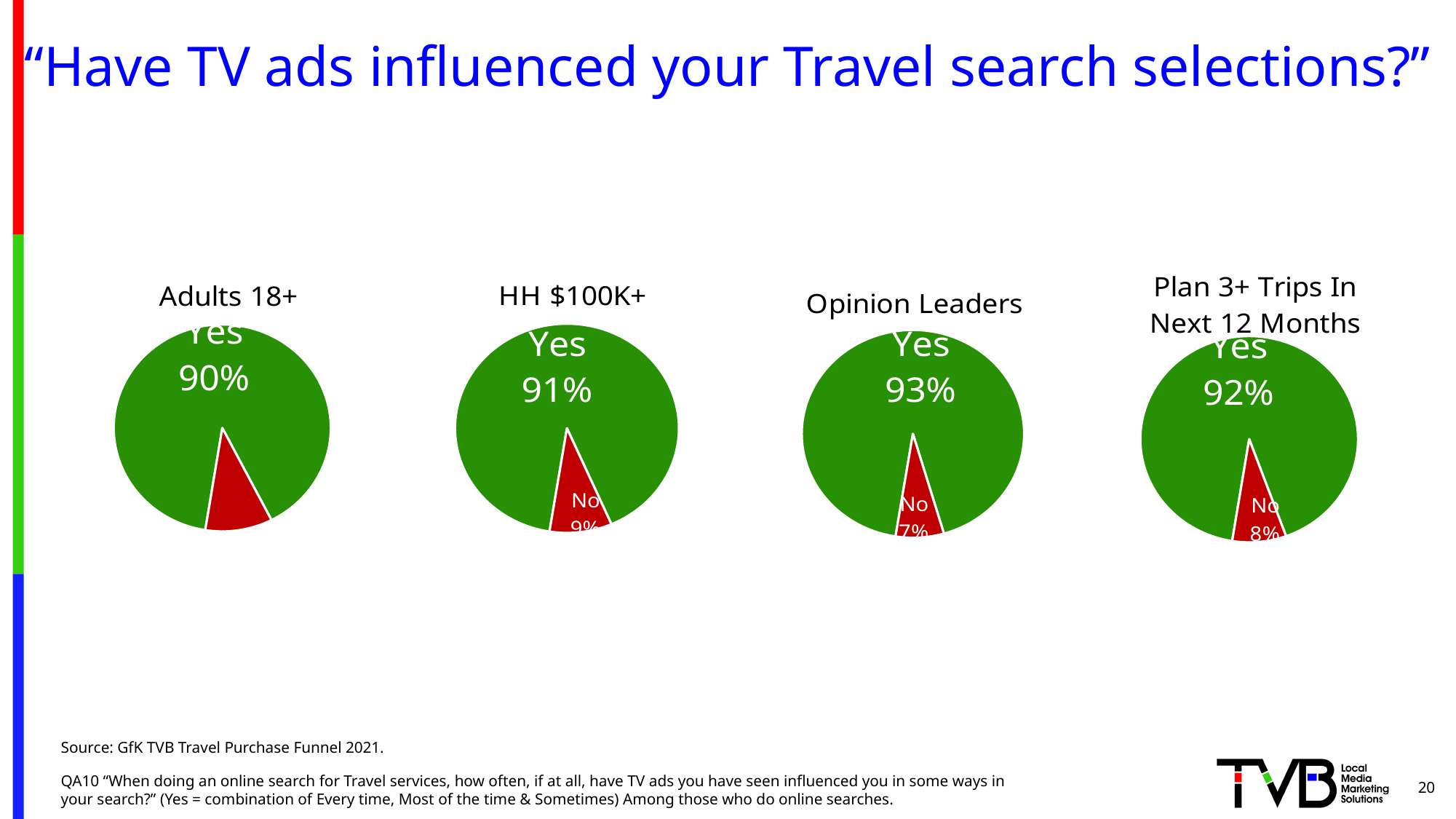
Which of the four charts shows the lowest Yes share? Adults 18+ How many pie charts are shown on the slide? 4 Is the Yes share larger in the HH $100K+ chart or in the Plan 3+ Trips In Next 12 Months chart? Plan 3+ Trips In Next 12 Months In the Opinion Leaders chart, what share of respondents answered No? 7% In the Adults 18+ chart, what share of respondents answered Yes? 90% In the Plan 3+ Trips In Next 12 Months chart, what share of respondents answered Yes? 92% In the HH $100K+ chart, what share of respondents answered Yes? 91% In the Opinion Leaders chart, what is the difference between the Yes and No shares? 86 percentage points In the HH $100K+ chart, what share of respondents answered No? 9% Which of the four charts shows the highest Yes share? Opinion Leaders What colour represents the Yes slice in each pie chart? Green What kind of chart is used on this slide? Pie chart